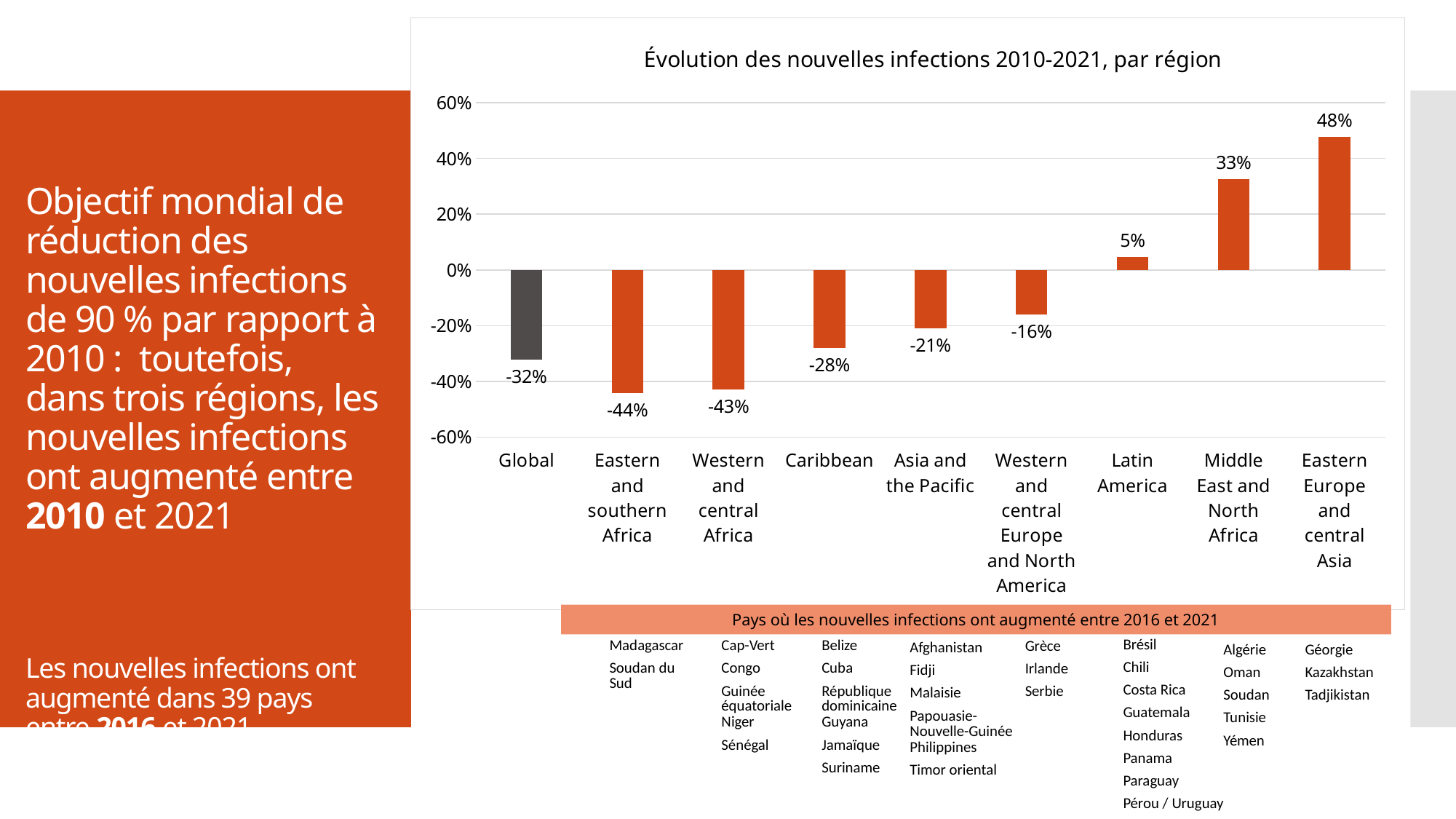
What kind of chart is shown on the slide? Bar chart Which bar in the chart is coloured dark grey instead of orange? Global What is the value for Global in the chart? -32% How many regions (categories) are shown in the chart? 9 What is the value for Eastern Europe and central Asia in the chart? 48% What is the difference between the values for Middle East and North Africa and Latin America? 28 percentage points Which region has the highest value in the chart? Eastern Europe and central Asia What is the value for Caribbean in the chart? -28% What is the title of the chart? Évolution des nouvelles infections 2010-2021, par région Which is larger, the value for Asia and the Pacific or the value for Western and central Europe and North America? Western and central Europe and North America What is the value for Latin America in the chart? 5% Which region has the lowest value in the chart? Eastern and southern Africa